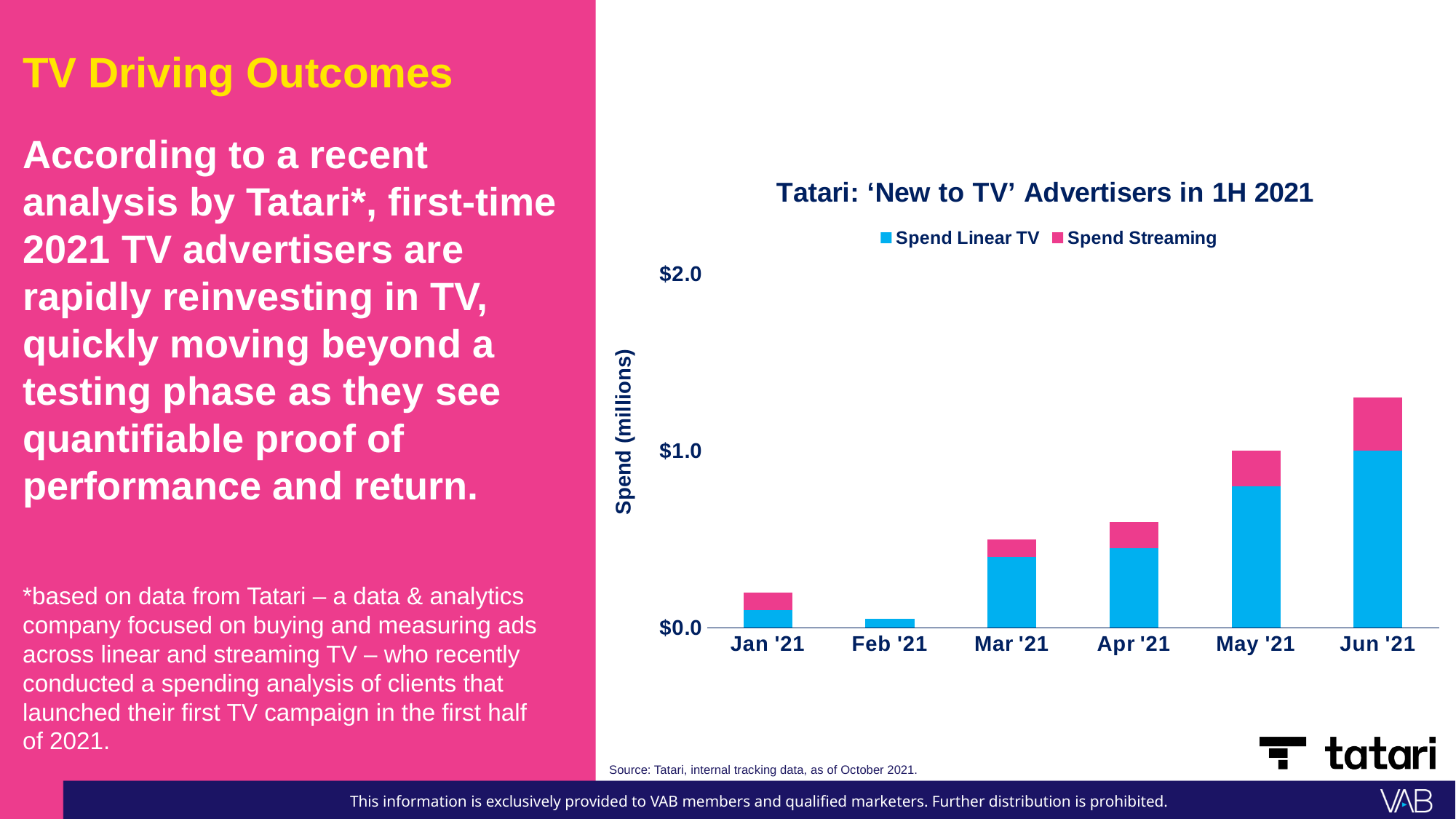
Which month has the lowest total spend in the chart? Feb '21 How many months are shown on the x axis of the chart? 6 What kind of chart is shown on the slide? Stacked bar chart What is the label on the chart's y axis? Spend (millions) Which month has the highest total spend in the chart? Jun '21 Is the total spend for Apr '21 greater or less than $1.0 million? less Is the total spend for Mar '21 greater or less than $1.0 million? less Do total spend values generally rise or fall from Jan '21 to Jun '21? rise Is the total spend for Jun '21 greater or less than $1.0 million? greater How many series does the chart's legend list? 2 Which month has the larger total spend, May '21 or Apr '21? May '21 What is the title of the chart? Tatari: 'New to TV' Advertisers in 1H 2021